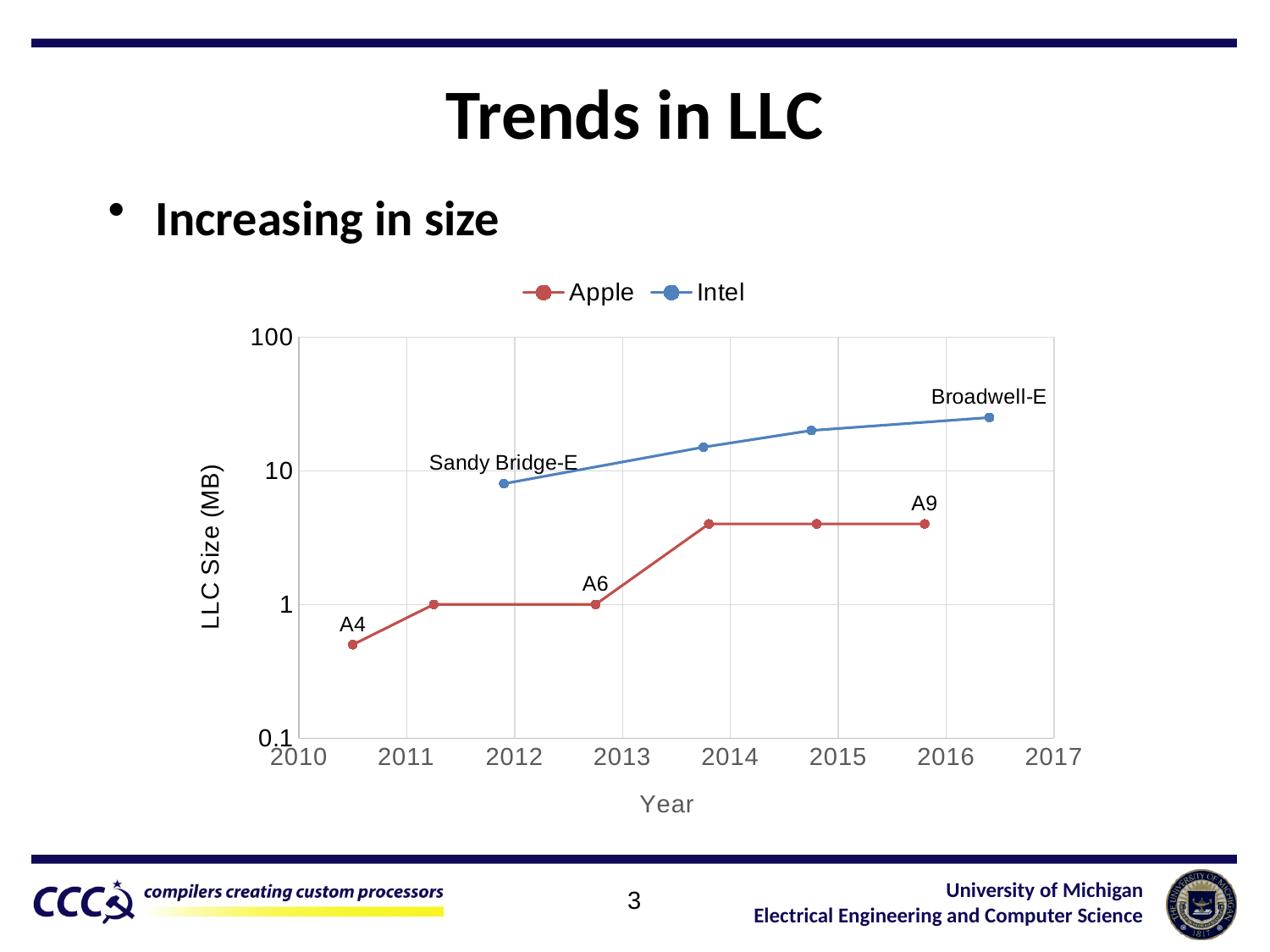
Is the LLC size for A4 greater or less than 1 MB? less Is the LLC size for A9 greater or less than 10 MB? less What kind of chart is shown on the slide? line chart What is the label of the y axis? LLC Size (MB) Does the Intel series rise or fall over the years shown? rise Is the LLC size for Broadwell-E greater or less than 10 MB? greater What is the LLC size of the A6 point? 1 MB How many data points are plotted for the Apple series? 6 How many series does the legend list? 2 Which two series are listed in the legend? Apple and Intel How many data points are plotted for the Intel series? 4 Which has the larger LLC size, Broadwell-E or A9? Broadwell-E